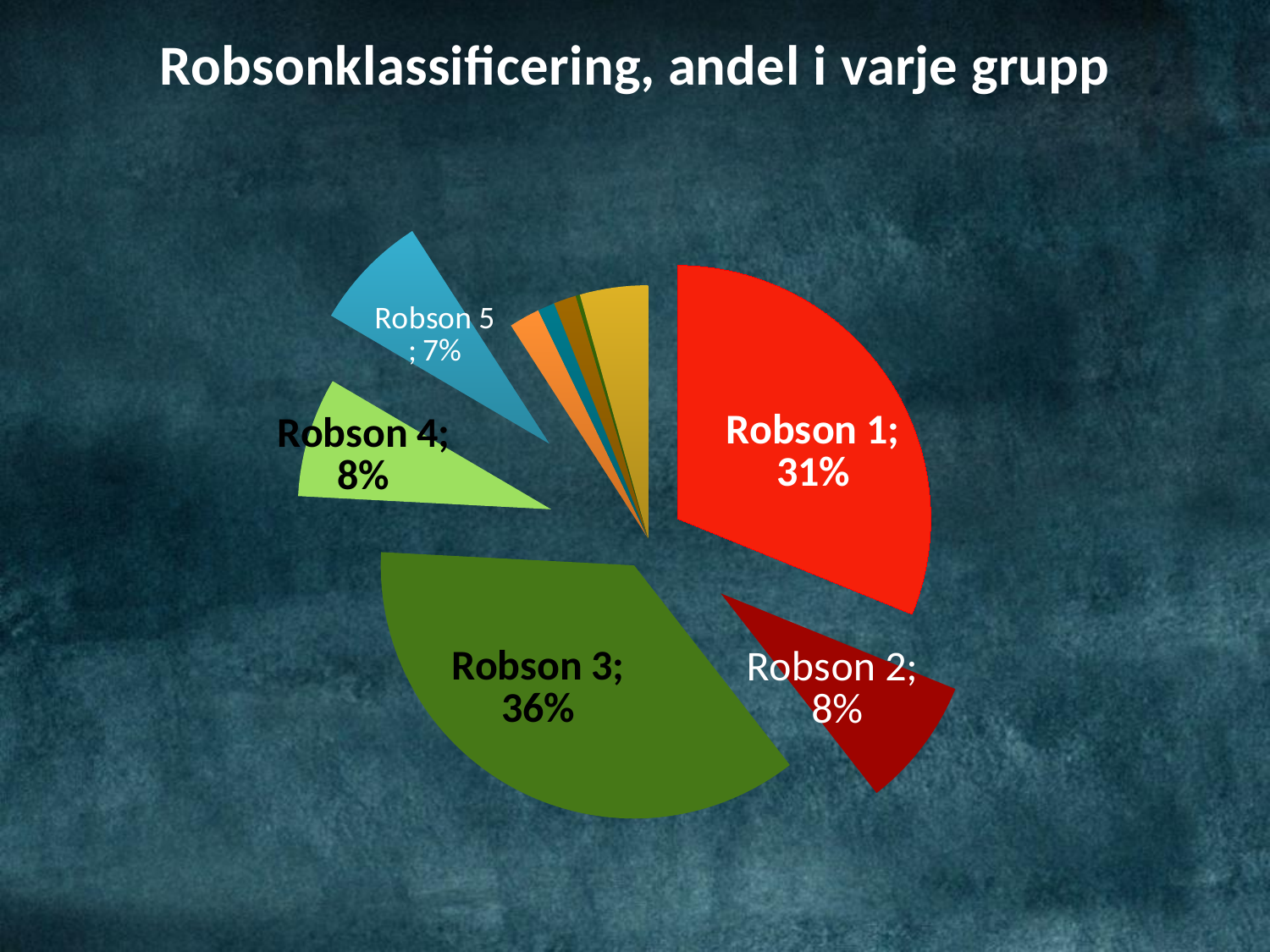
What share of the pie does Robson 5 have? 7% What share of the pie does Robson 2 have? 8% What is the title of the chart? Robsonklassificering, andel i varje grupp What kind of chart is shown on the slide? pie chart Which labelled group has the largest share of the pie? Robson 3 What share of the pie does Robson 1 have? 31% How many percentage points larger is the share of Robson 1 than that of Robson 5? 24% Among the labelled slices, which group has the smallest share? Robson 5 Which has a larger share, Robson 1 or Robson 3? Robson 3 What share of the pie does Robson 3 have? 36% How many percentage points larger is the share of Robson 3 than that of Robson 1? 5% Which has a larger share, Robson 4 or Robson 5? Robson 4